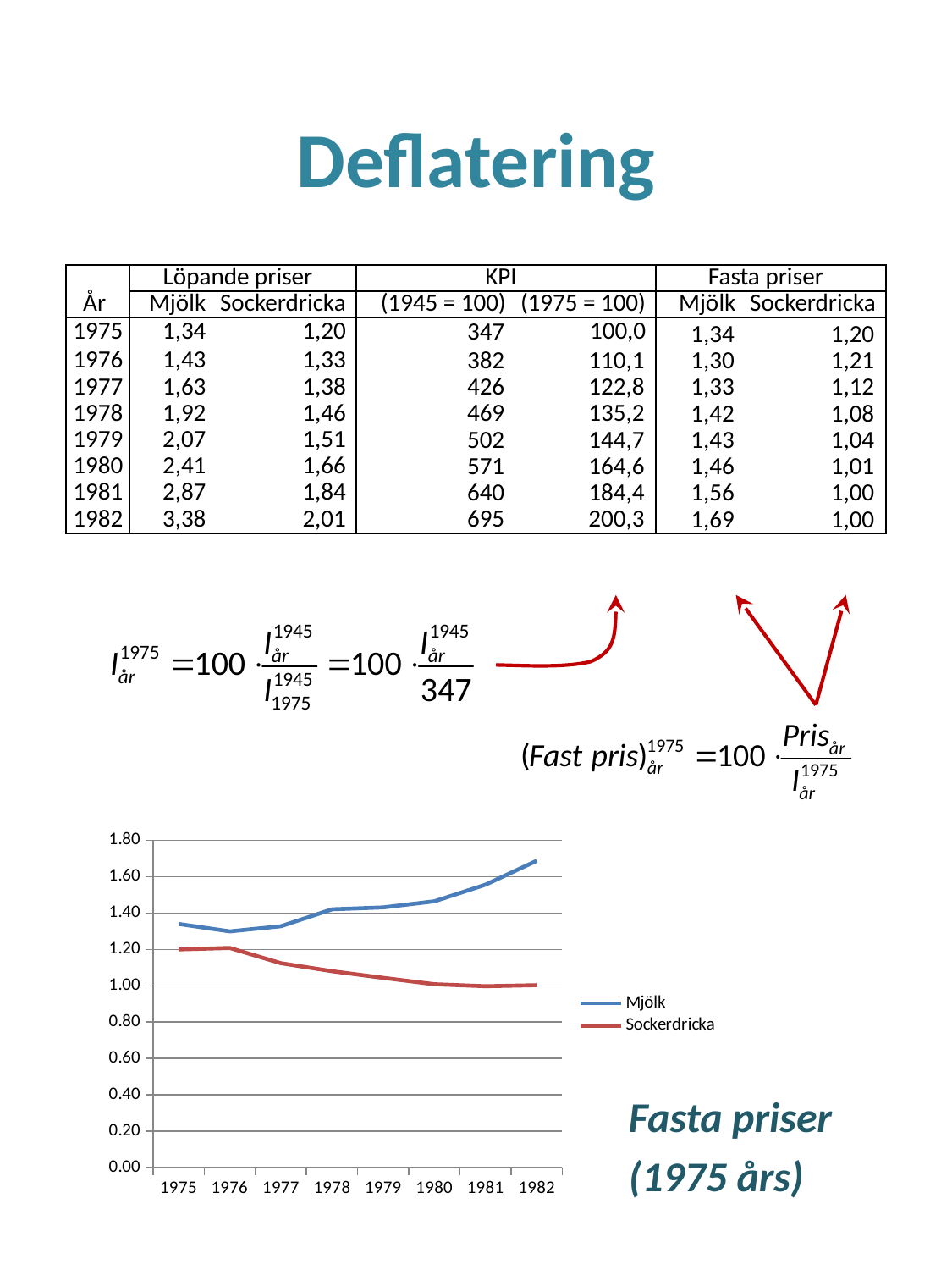
How many series does the chart legend list? 2 In 1982, which series has the larger value, Mjölk or Sockerdricka? Mjölk What type of chart is shown on the slide? line chart Which series does the blue line represent? Mjölk How many years are plotted along the x axis of the chart? 8 Is the value for Mjölk in 1982 greater or less than 1.60? greater Does the Mjölk line rise or fall from 1975 to 1982? rises Is the value for Mjölk in 1975 greater or less than 1.20? greater Is the value for Sockerdricka in 1977 greater or less than 1.00? greater In which year does the Mjölk line reach its highest value? 1982 What is the value for Sockerdricka in 1982? 1,00 Does the Sockerdricka line rise or fall from 1976 to 1982? falls